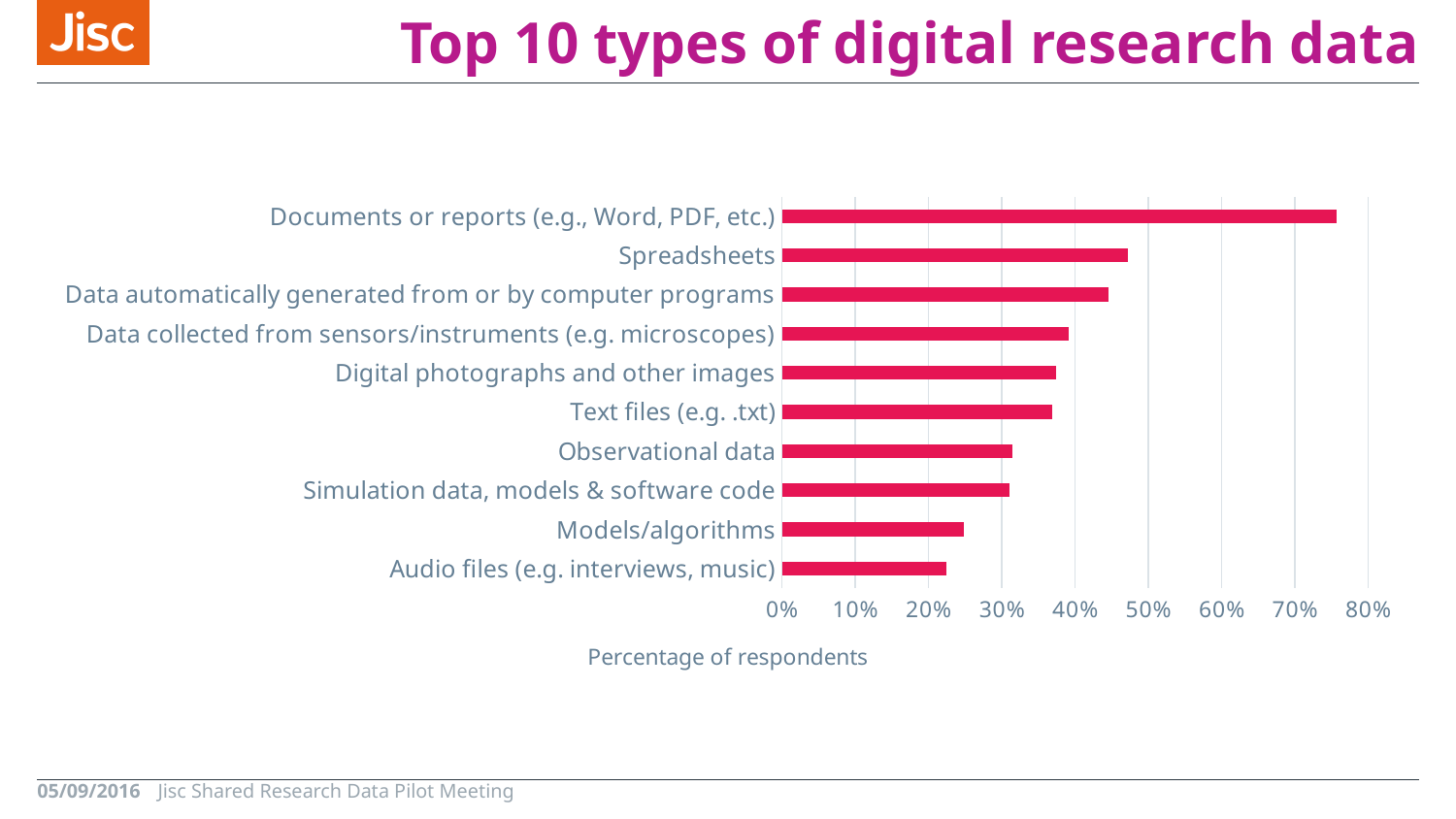
What is the title of the chart on the slide? Top 10 types of digital research data Which has a higher percentage of respondents: Spreadsheets or Text files (e.g. .txt)? Spreadsheets Which type of digital research data has the highest percentage of respondents? Documents or reports (e.g., Word, PDF, etc.) Which has a higher percentage of respondents: Observational data or Models/algorithms? Observational data How many types of digital research data are listed in the chart? 10 Which type of digital research data has the lowest percentage of respondents? Audio files (e.g. interviews, music) Is the value for Spreadsheets greater or less than 50%? less Is the value for Documents or reports (e.g., Word, PDF, etc.) greater or less than 70%? greater What kind of chart is shown on the slide? bar chart Is the value for Audio files (e.g. interviews, music) greater or less than 20%? greater What is the label of the horizontal axis of the chart? Percentage of respondents